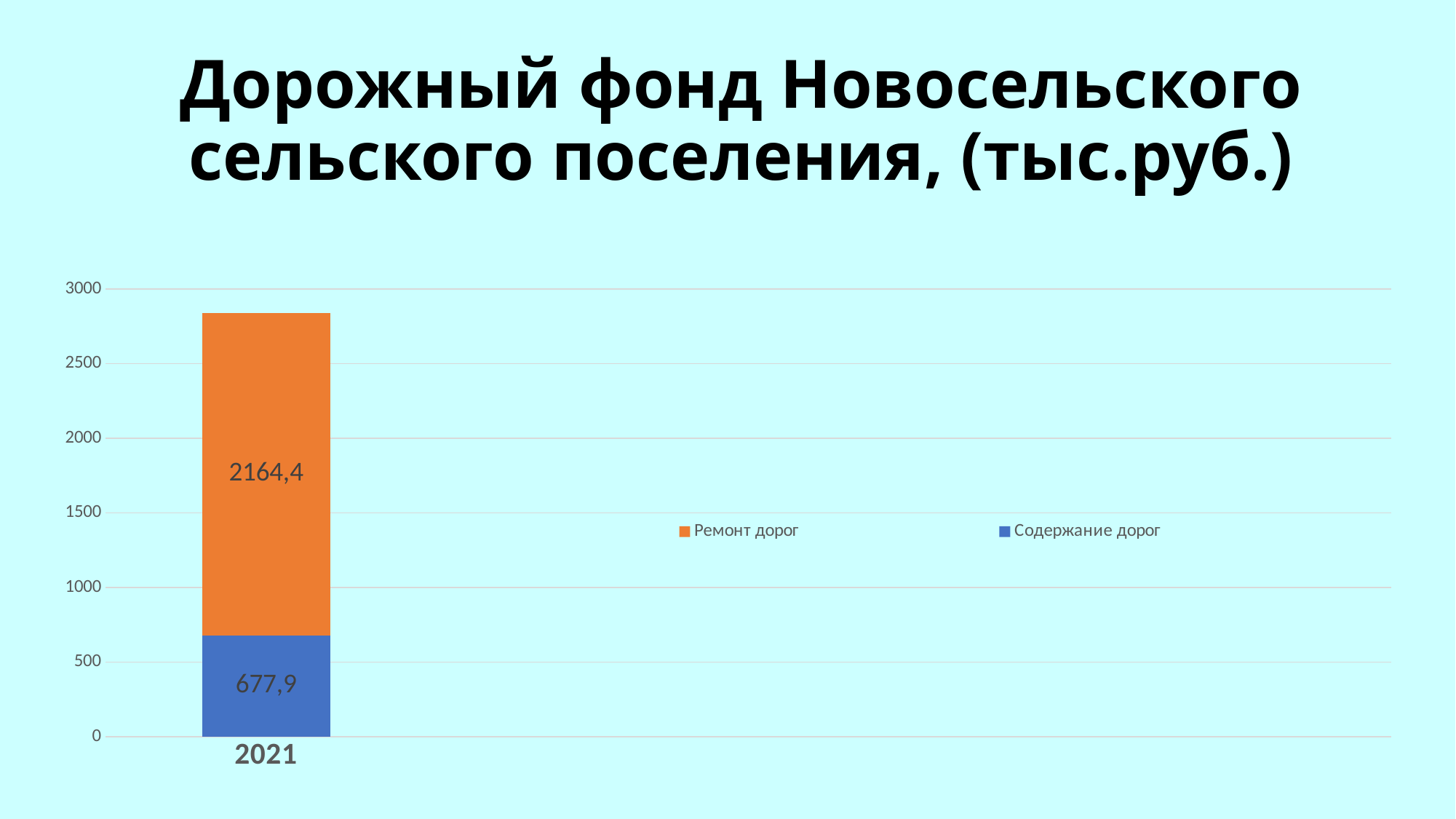
What kind of chart is shown on the slide? stacked bar chart How many categories are shown on the x axis? 1 Which series has the larger value in 2021, Ремонт дорог or Содержание дорог? Ремонт дорог What is the total of the stacked bar for 2021? 2842,3 What is the title of the chart? Дорожный фонд Новосельского сельского поселения, (тыс.руб.) Is the total height of the 2021 bar greater or less than 3000? less Is the value for Содержание дорог in 2021 greater or less than 500? greater How many series does the legend list? 2 What is the value for Ремонт дорог in 2021? 2164,4 What is the value for Содержание дорог in 2021? 677,9 Which colour represents Содержание дорог in the chart? blue What is the difference between Ремонт дорог and Содержание дорог in 2021? 1486,5